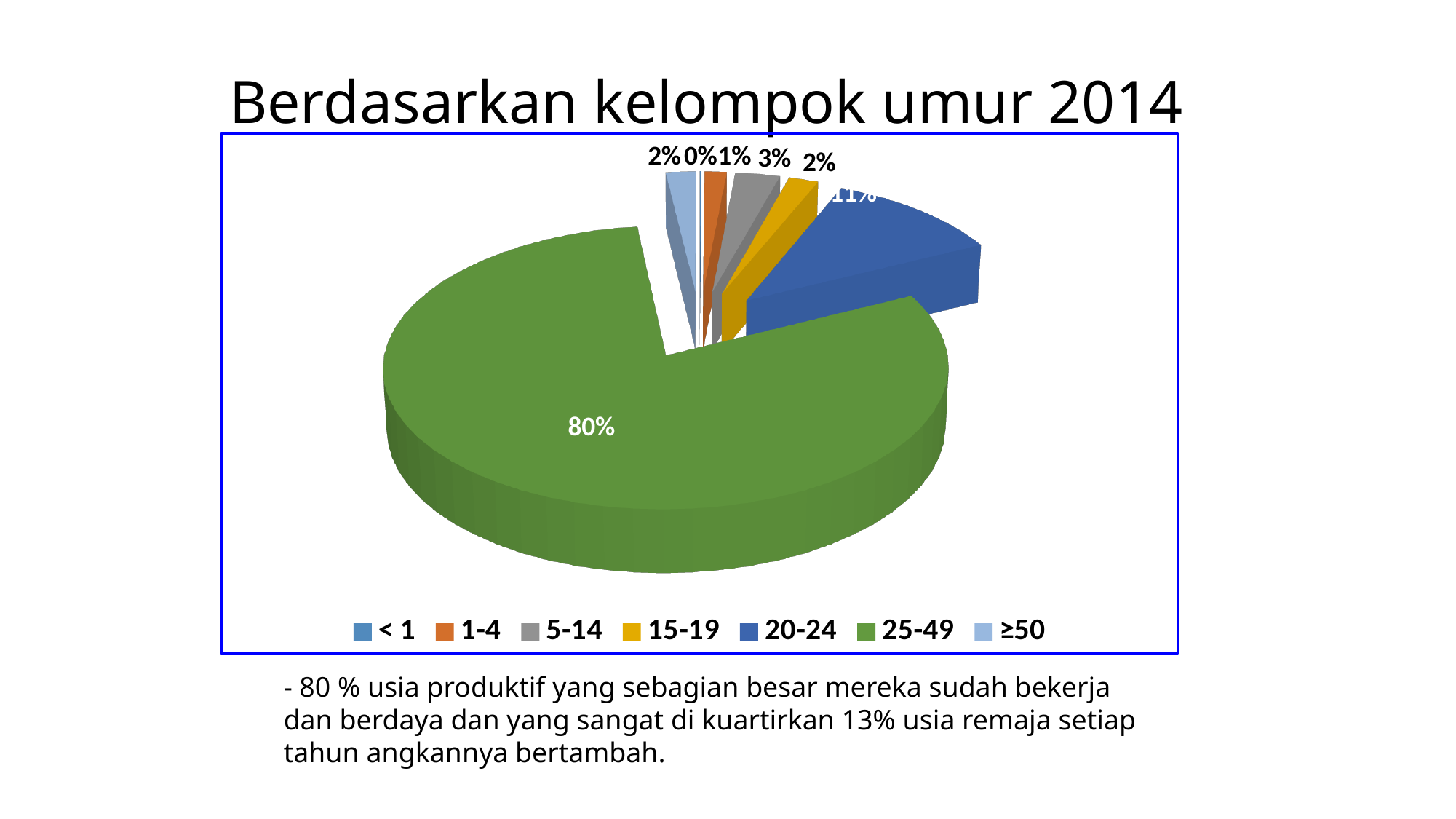
What kind of chart is shown on the slide? pie chart Which age group has the largest share of the pie? 25-49 What percentage is shown for the ≥50 age group? 2% What percentage is shown for the 5-14 age group? 3% What percentage is shown for the 15-19 age group? 2% What percentage is shown for the 1-4 age group? 1% What is the difference in percentage points between the 25-49 group and the 5-14 group? 77% What is the title of the slide? Berdasarkan kelompok umur 2014 How many age groups are listed in the legend? 7 Which has the larger share, the 5-14 group or the 1-4 group? 5-14 What percentage is shown for the < 1 age group? 0% What percentage is shown for the 25-49 age group? 80%